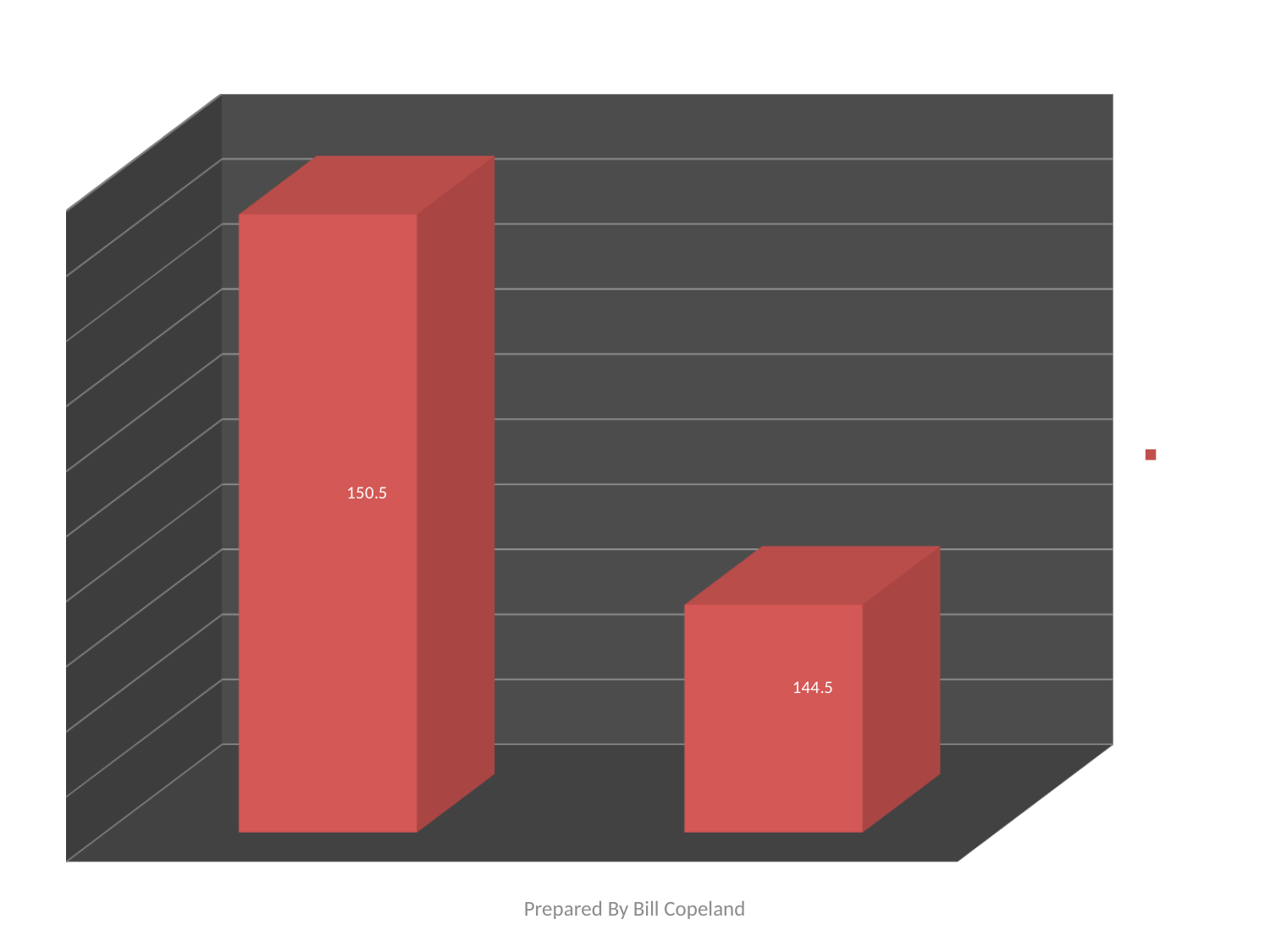
Which bar has the higher value, the left or the right? left What value is shown on the left bar? 150.5 Do the bar values rise or fall from left to right? fall How many entries does the legend show? 1 What text appears below the chart? Prepared By Bill Copeland What kind of chart is shown on the slide? bar chart What colour are the bars in the chart? red How many bars are plotted in the chart? 2 Is the value of the left bar larger or smaller than the value of the right bar? larger Which bar has the lower value, the left or the right? right What is the difference between the values of the left bar and the right bar? 6 What value is shown on the right bar? 144.5